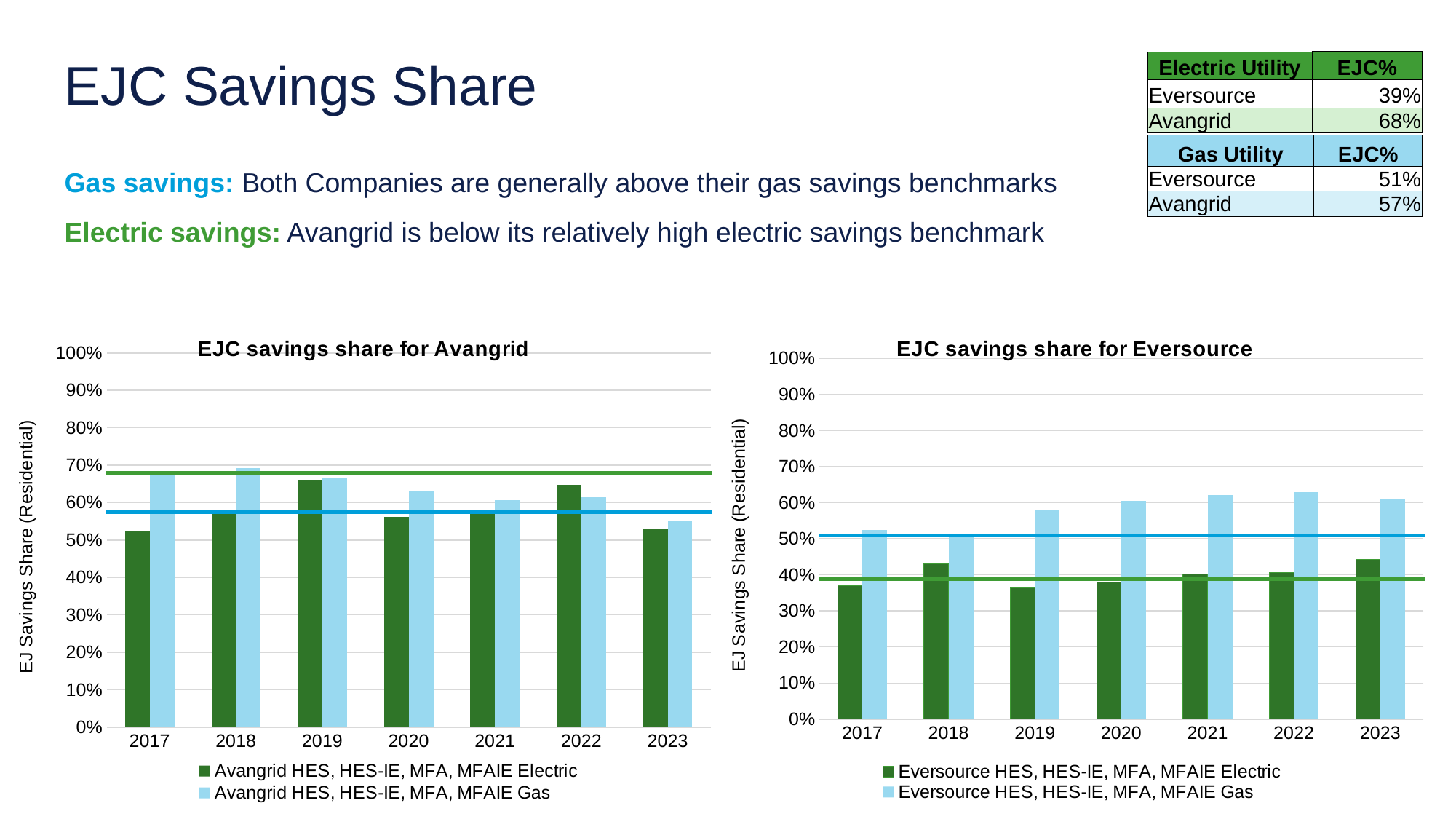
In the 'EJC savings share for Eversource' chart, how many series does the legend list? 2 In the 'EJC savings share for Eversource' chart, is the Gas value for 2021 greater or less than 60%? greater In the 'EJC savings share for Avangrid' chart, is the Gas value for 2023 greater or less than 60%? less In the 'EJC savings share for Eversource' chart, is the Electric value for 2017 greater or less than 40%? less In the 'EJC savings share for Avangrid' chart, how many years are shown on the x axis? 7 In the 'EJC savings share for Eversource' chart, do the Gas values generally rise or fall from 2017 to 2022? rise In the 'EJC savings share for Avangrid' chart, which is larger for 2022, the Electric value or the Gas value? Electric In the 'EJC savings share for Eversource' chart, which is larger for 2020, the Electric value or the Gas value? Gas What is the y-axis title of the 'EJC savings share for Eversource' chart? EJ Savings Share (Residential) In the 'EJC savings share for Avangrid' chart, which year has the lowest Gas value? 2023 What kind of chart is the 'EJC savings share for Avangrid' chart? bar chart